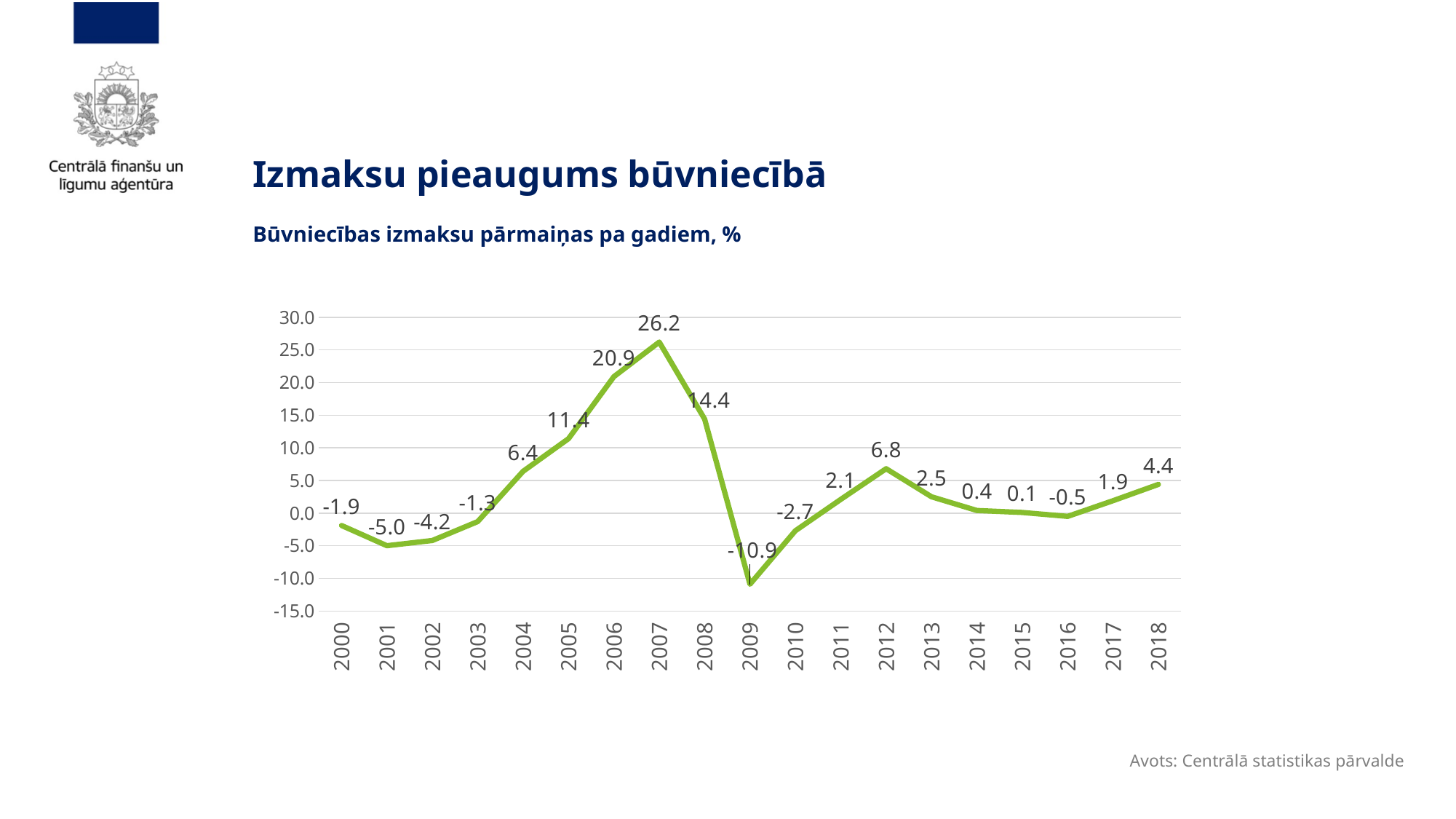
Which year has the lowest value? 2009 Which year has the highest value? 2007 What is the value for 2018? 4.4 What is the value for 2009? -10.9 How many years are plotted on the x axis? 19 Which is larger, the value for 2012 or the value for 2013? 2012 What kind of chart is shown? line chart Do the values rise or fall from 2003 to 2007? rise What is the chart's subtitle? Būvniecības izmaksu pārmaiņas pa gadiem, % What colour is the line in the chart? green What is the difference between the values for 2007 and 2006? 5.3 What is the value for 2007? 26.2